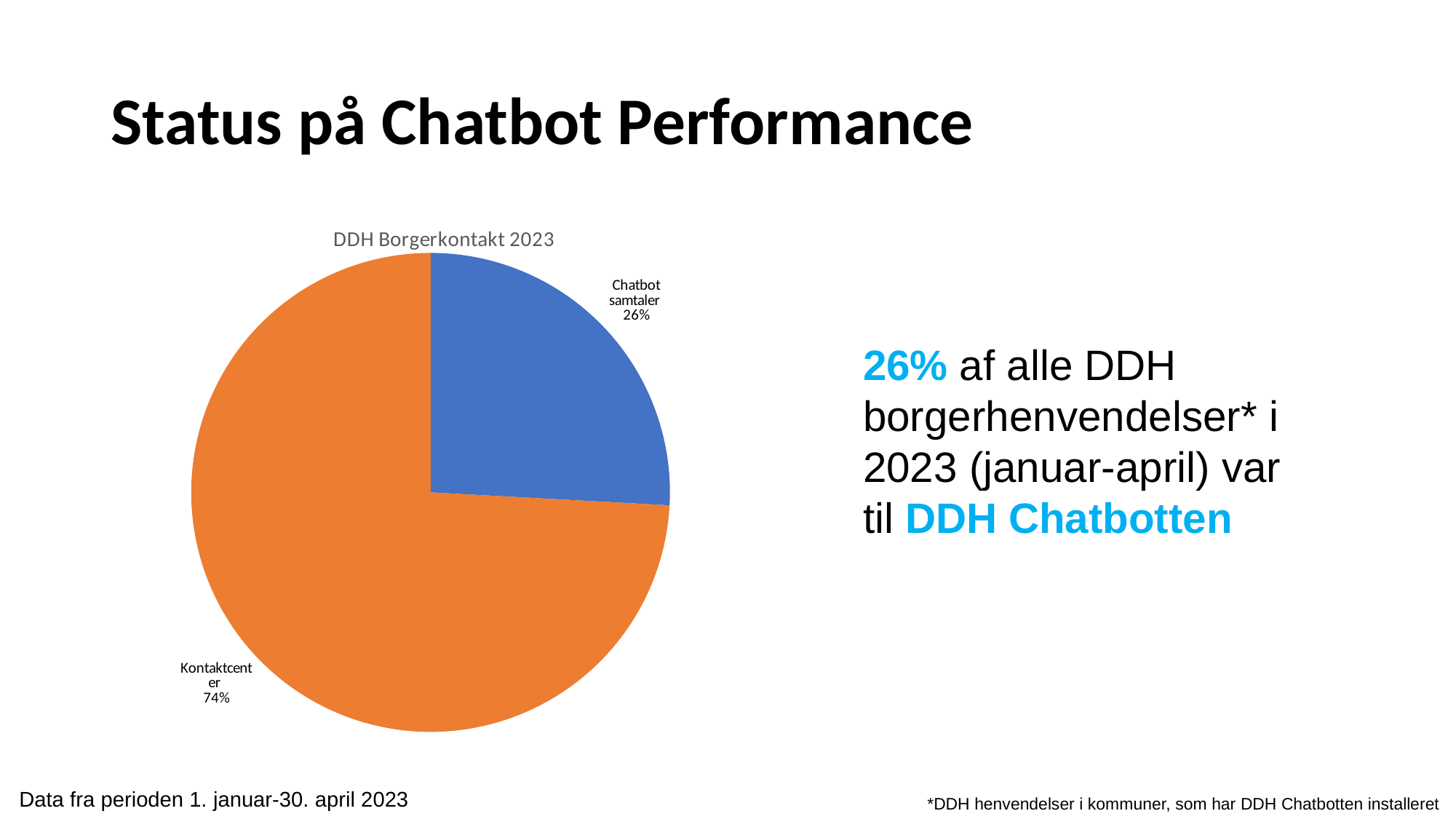
Which is larger, the Chatbot samtaler slice or the Kontaktcenter slice? Kontaktcenter Which slice of the pie is the largest? Kontaktcenter What kind of chart is shown on the slide? pie chart How many slices does the pie chart have? 2 What is the title of the chart? DDH Borgerkontakt 2023 What colour is the Kontaktcenter slice? orange Is the share for Chatbot samtaler greater or less than 50%? less What share of the pie is Chatbot samtaler? 26% What share of the pie is Kontaktcenter? 74% What is the difference in percentage points between the Kontaktcenter slice and the Chatbot samtaler slice? 48 Which slice of the pie is the smallest? Chatbot samtaler